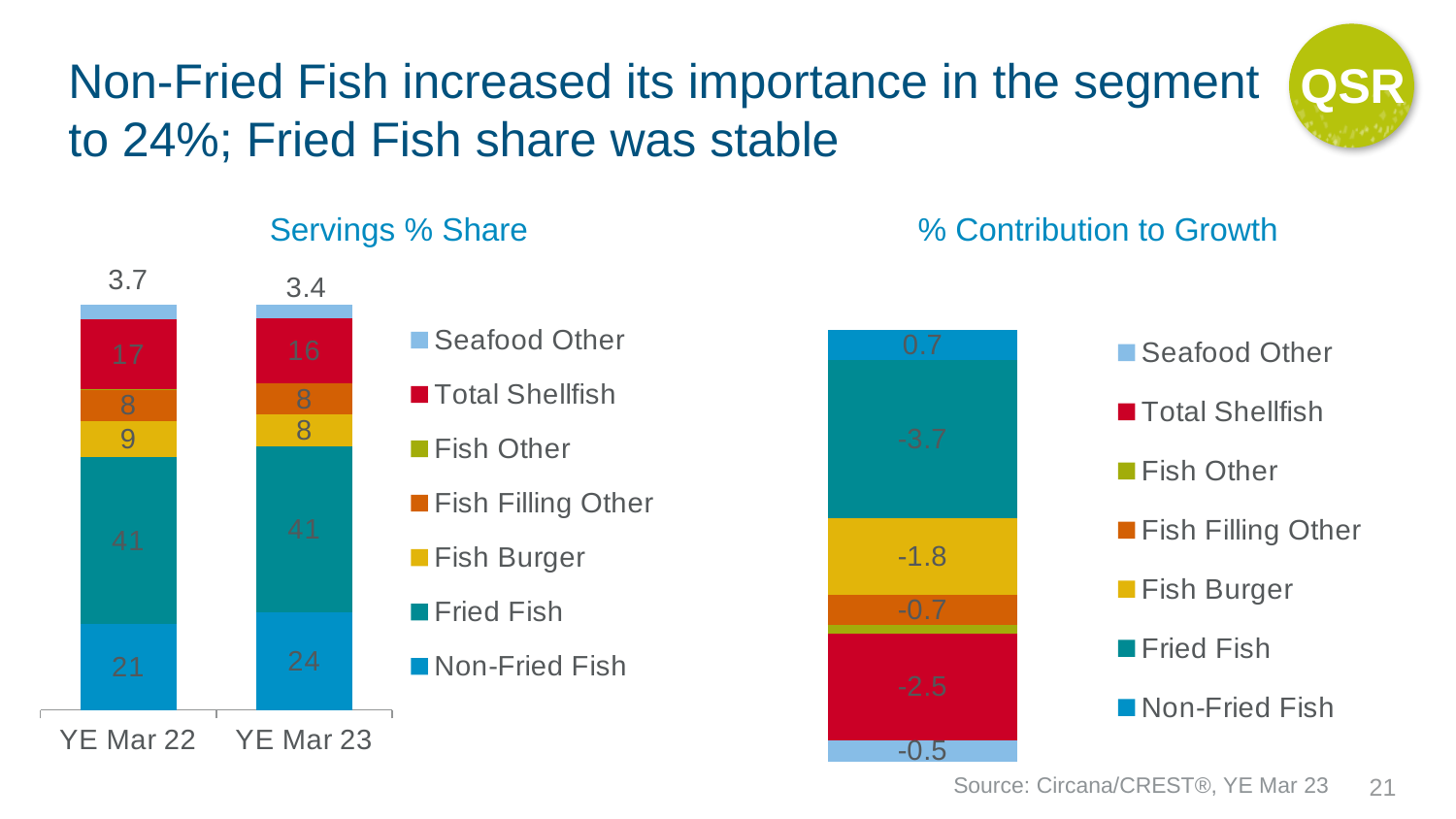
How many time periods are shown on the x axis of the Servings % Share chart? 2 In the Servings % Share chart, by how much did the Non-Fried Fish value increase from YE Mar 22 to YE Mar 23? 3 In the Servings % Share chart, is the Total Shellfish value larger in YE Mar 22 or YE Mar 23? YE Mar 22 In the Servings % Share chart, what is the value for Non-Fried Fish in YE Mar 23? 24 In the Servings % Share chart, what is the value for Seafood Other in YE Mar 22? 3.7 In the Servings % Share chart, what is the value for Total Shellfish in YE Mar 23? 16 In the Servings % Share chart, does the Non-Fried Fish value rise or fall from YE Mar 22 to YE Mar 23? rise In the % Contribution to Growth chart, what is the value for Fried Fish? -3.7 In the Servings % Share chart, what is the value for Fried Fish in YE Mar 22? 41 In the % Contribution to Growth chart, which segment has the lowest (most negative) value? Fried Fish What kind of chart is the Servings % Share chart? stacked bar chart How many series does the legend of the Servings % Share chart list? 7